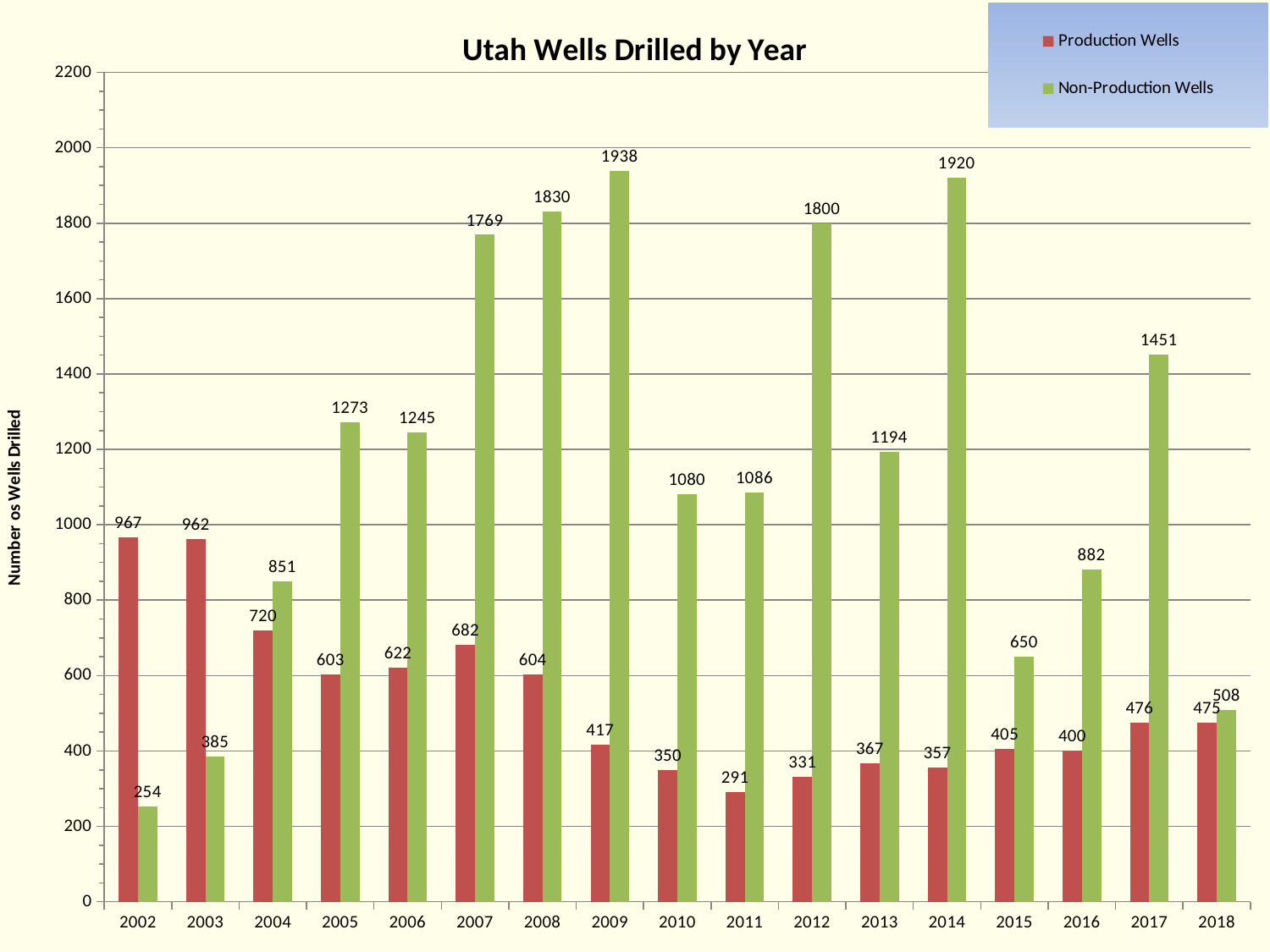
Is the value for Non-Production Wells in 2012 greater or less than 1600? greater Which year has the lowest value for Production Wells? 2011 How many series does the legend list? 2 Which is larger in 2003, Production Wells or Non-Production Wells? Production Wells What is the value for Non-Production Wells in 2017? 1451 What is the title of the chart? Utah Wells Drilled by Year What kind of chart is shown on the slide? bar chart What is the value for Non-Production Wells in 2009? 1938 How many years are shown on the x axis? 17 What is the value for Production Wells in 2002? 967 What is the difference between Non-Production Wells and Production Wells in 2014? 1563 Which year has the highest value for Non-Production Wells? 2009